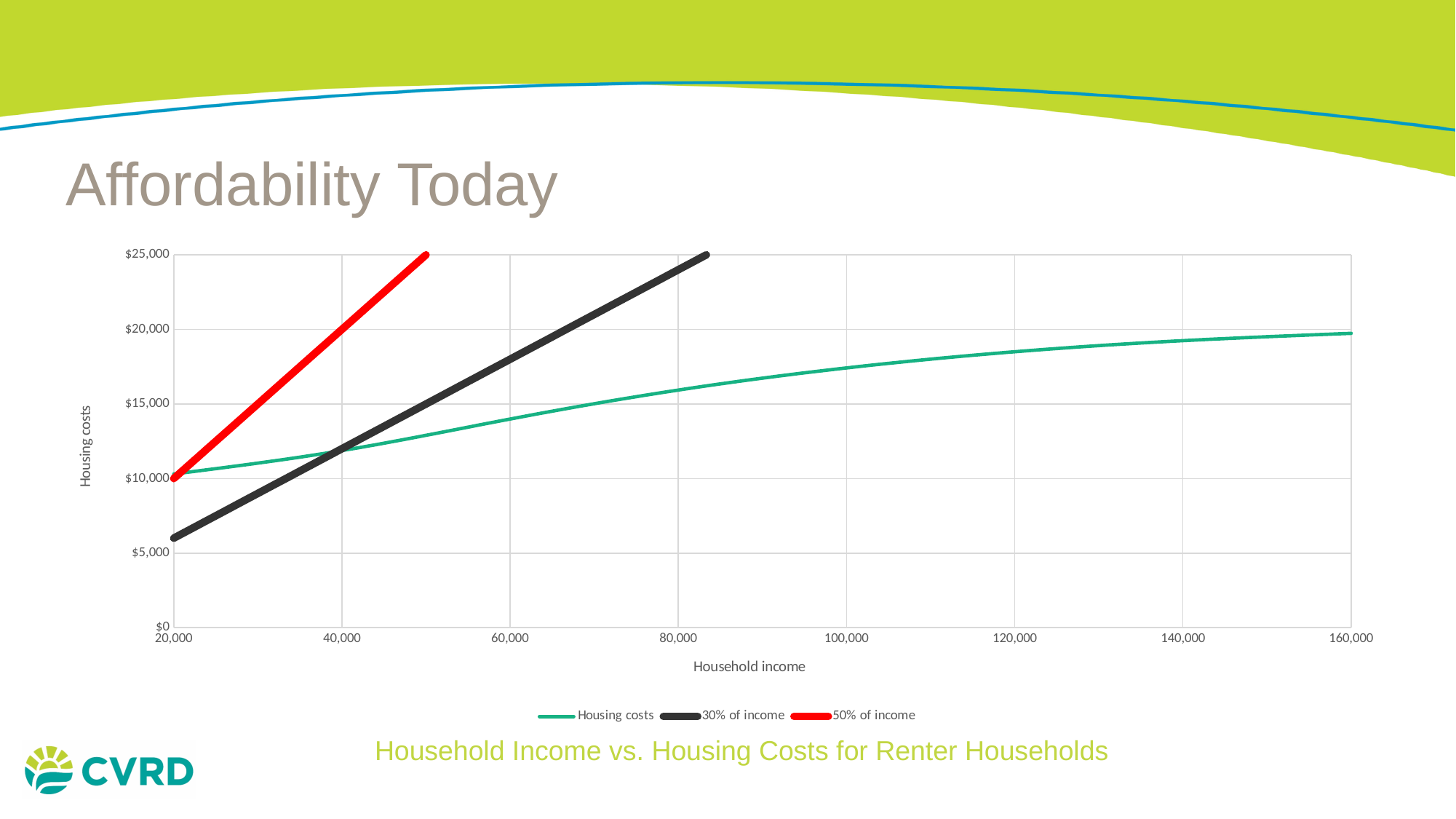
What kind of chart is shown on the slide? line chart What is the value of the 50% of income line at a household income of 20,000? $10,000 What are the three series listed in the chart legend? Housing costs, 30% of income, 50% of income At a household income of 40,000, which line is higher: 50% of income or Housing costs? 50% of income Does the Housing costs line rise or fall as household income increases? rise What is the label of the chart's x axis? Household income How many series does the chart legend list? 3 Is the Housing costs value at a household income of 160,000 greater or less than $15,000? greater At a household income of 20,000, which line is higher: Housing costs or 30% of income? Housing costs Is the Housing costs value at a household income of 160,000 greater or less than $20,000? less Is the 30% of income value at a household income of 20,000 greater or less than $5,000? greater